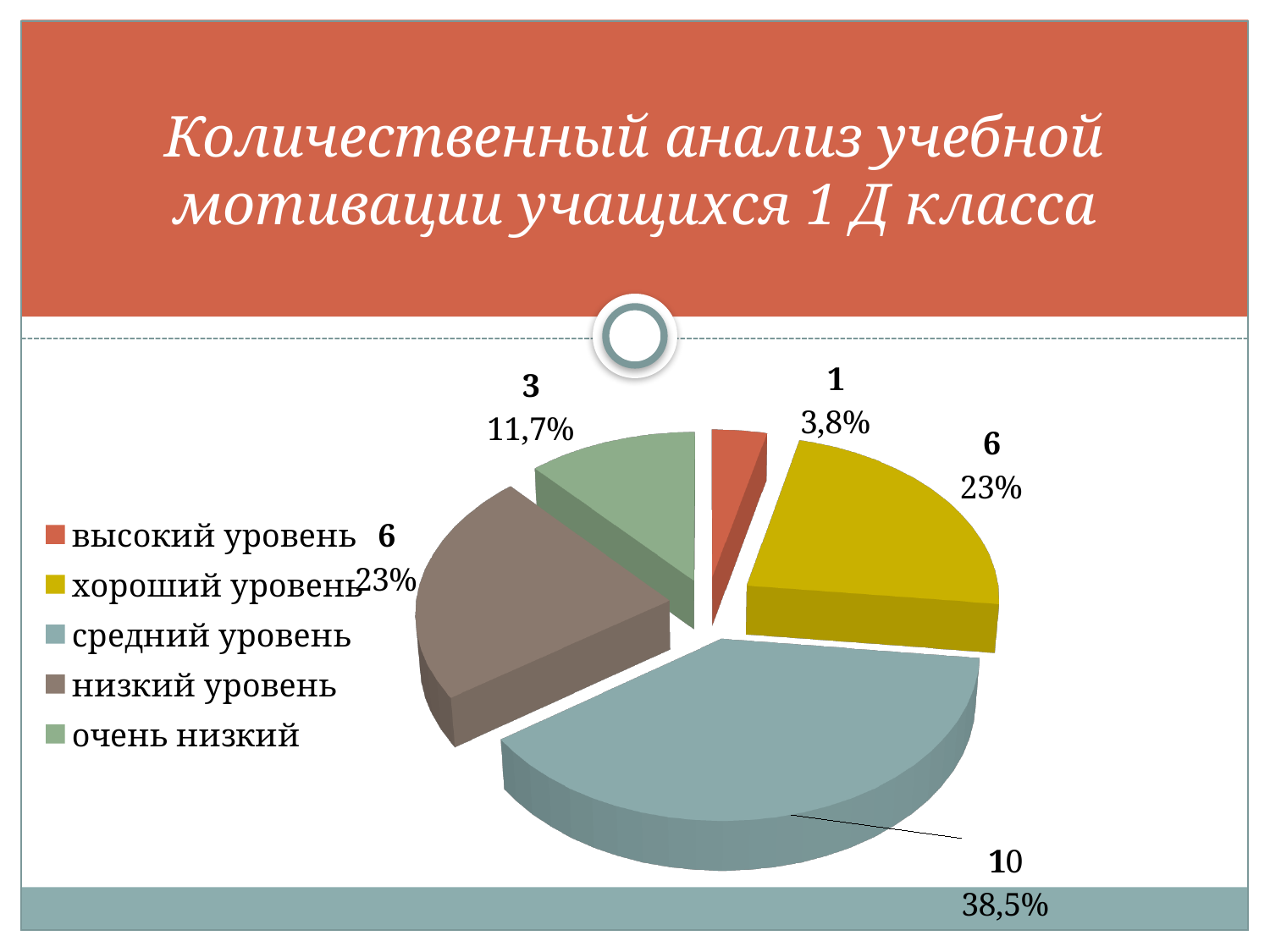
What is the value shown for the 'высокий уровень' slice? 1 What percentage share is shown for the 'высокий уровень' slice? 3,8% Which category has the largest slice of the pie? средний уровень What kind of chart is shown on the slide? pie chart How many categories does the legend of the pie chart list? 5 Which is larger, the value for 'хороший уровень' or the value for 'очень низкий'? хороший уровень What is the difference between the values for 'средний уровень' and 'очень низкий'? 7 What is the value shown for the 'очень низкий' slice? 3 What percentage share is shown for the 'средний уровень' slice? 38,5% What is the value shown for the 'средний уровень' slice? 10 Which category has the smallest slice of the pie? высокий уровень What percentage share is shown for the 'очень низкий' slice? 11,7%